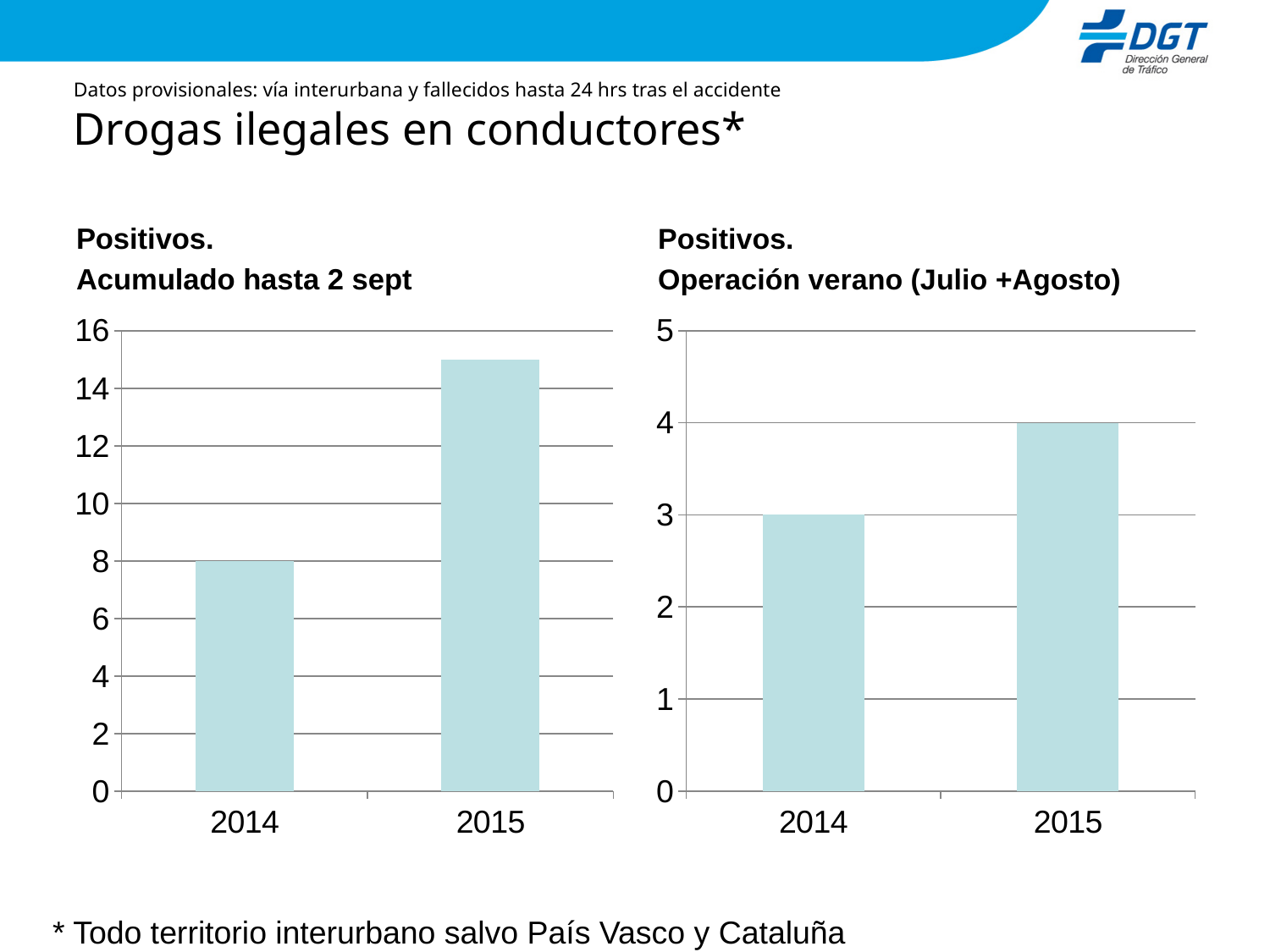
In the right chart (Operación verano), what is the value for 2015? 4 In the left chart (Acumulado hasta 2 sept), is the value for 2015 greater or less than 14? greater In the right chart (Operación verano), do the values rise or fall from 2014 to 2015? rise What type of chart is the left chart (Acumulado hasta 2 sept)? bar chart In the left chart (Acumulado hasta 2 sept), which year has the higher value? 2015 What is the title of the right chart? Positivos. Operación verano (Julio +Agosto) In the right chart (Operación verano), which year has the lower value? 2014 How many bars are shown in the right chart (Operación verano)? 2 In the left chart (Acumulado hasta 2 sept), is the value for 2014 larger or smaller than the value for 2015? smaller In the left chart (Acumulado hasta 2 sept), what is the value for 2014? 8 In the right chart (Operación verano), what is the difference between the 2015 and 2014 values? 1 In the right chart (Operación verano), what is the value for 2014? 3